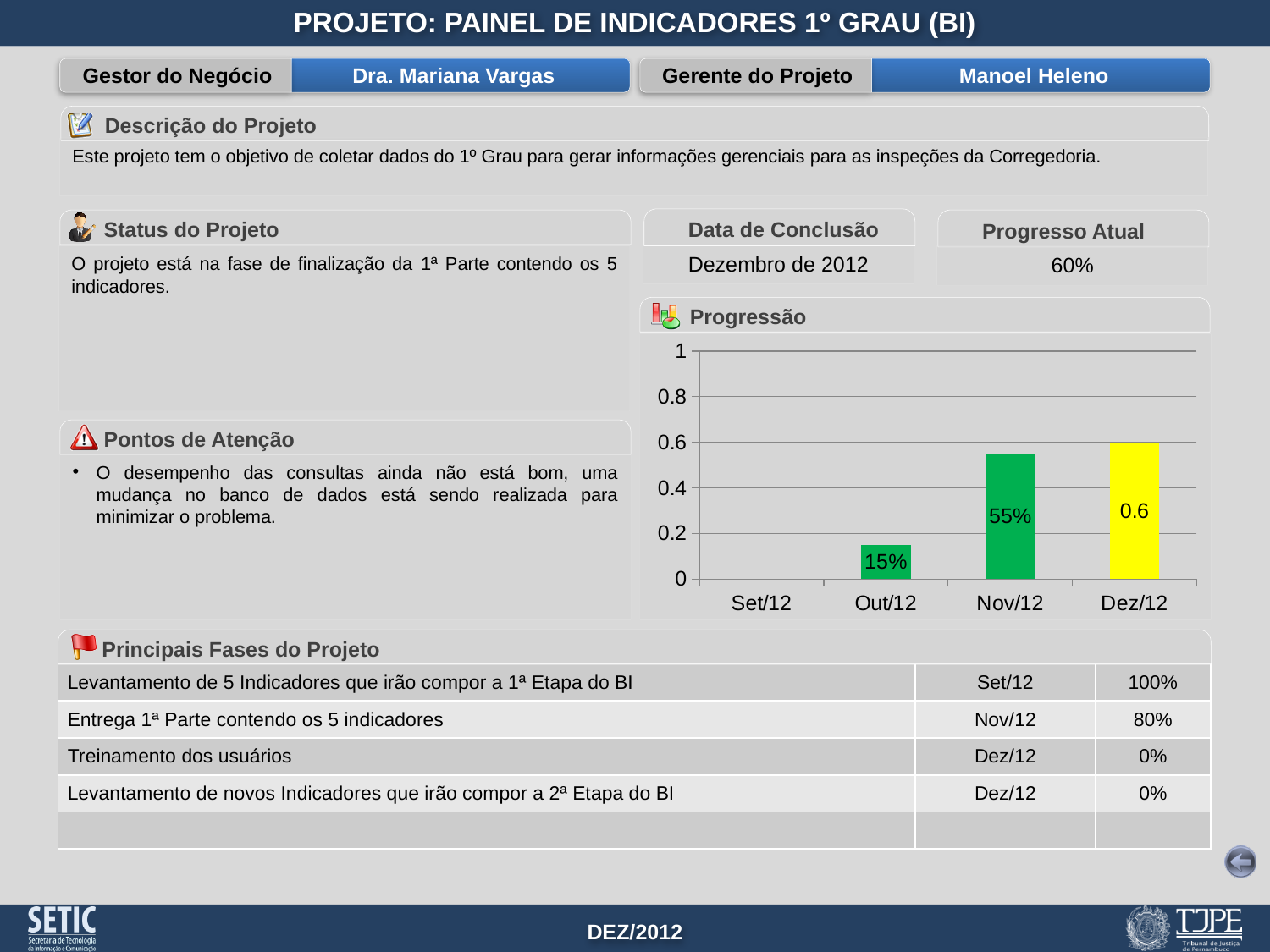
What is the value shown for Dez/12 in the Progressão chart? 0.6 What kind of chart is the Progressão chart? bar chart Which of Out/12 or Nov/12 has the larger value in the Progressão chart? Nov/12 Is the value for Nov/12 in the Progressão chart greater or less than 0.4? greater What is the value for Nov/12 in the Progressão chart? 55% Do the values in the Progressão chart rise or fall from Out/12 to Dez/12? rise What is the value for Out/12 in the Progressão chart? 15% Which month has the highest bar in the Progressão chart? Dez/12 What is the difference between the Nov/12 and Out/12 values in the Progressão chart? 40% What colour is the Dez/12 bar in the Progressão chart? yellow Is the value for Out/12 in the Progressão chart greater or less than 0.2? less How many months are shown on the x axis of the Progressão chart? 4